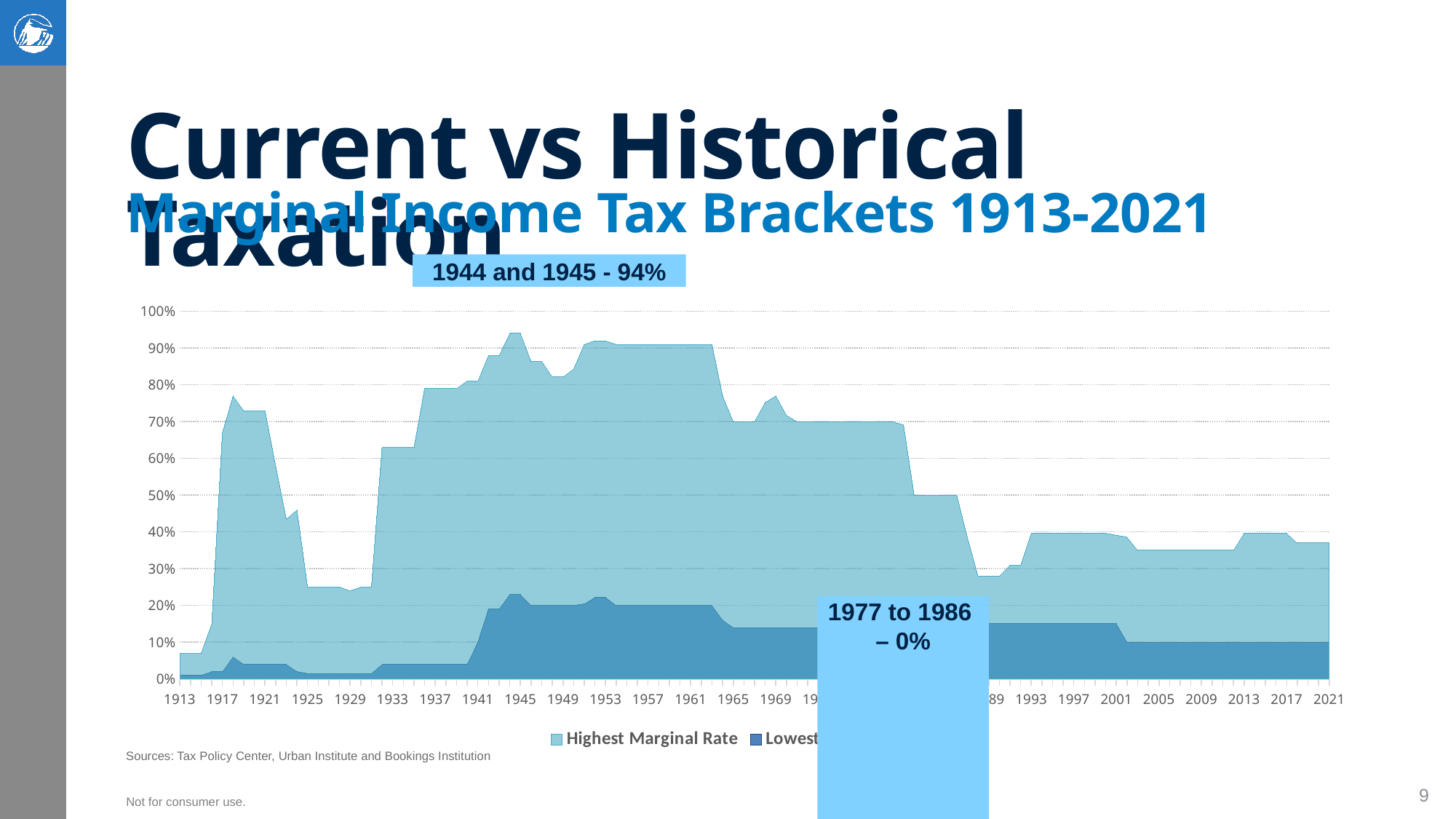
What kind of chart is shown on the slide? Area chart In which years did the highest marginal rate reach its peak? 1944 and 1945 What was the lowest marginal rate from 1977 to 1986, according to the callout on the chart? 0% Is the highest marginal rate in 1913 greater or less than 10%? less What was the highest marginal rate in 1944 and 1945, according to the callout on the chart? 94% Is the highest marginal rate in 1925 greater or less than 50%? less What is the title of the chart? Marginal Income Tax Brackets 1913-2021 Which year had a larger highest marginal rate, 1961 or 2021? 1961 How many series does the chart's legend list? 2 Is the highest marginal rate in 2021 greater or less than 30%? greater Does the highest marginal rate generally rise or fall from 1961 to 2021? fall